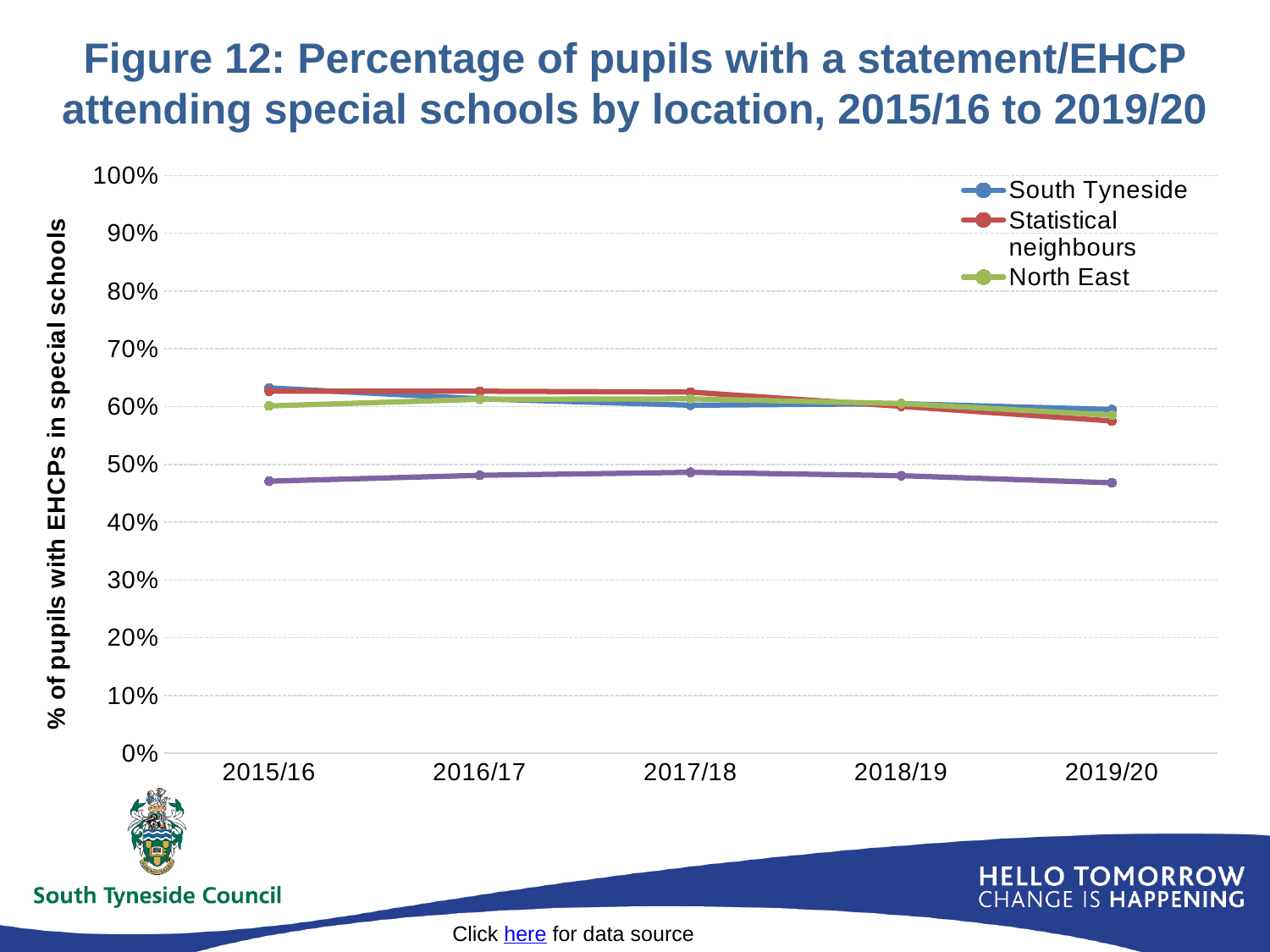
What is the title of the y axis? % of pupils with EHCPs in special schools How many academic years are shown on the x axis? 5 What colour is the North East line? green Is the value for Statistical neighbours in 2019/20 greater or less than 60%? less In 2015/16, which is larger: the value for South Tyneside or the value for North East? South Tyneside Is the value for Statistical neighbours in 2017/18 greater or less than 70%? less Is the value for South Tyneside in 2015/16 greater or less than 60%? greater Does the Statistical neighbours line rise or fall from 2017/18 to 2019/20? fall Does the South Tyneside line rise or fall from 2015/16 to 2019/20? fall What kind of chart is shown on the slide? line chart How many series does the legend list? 3